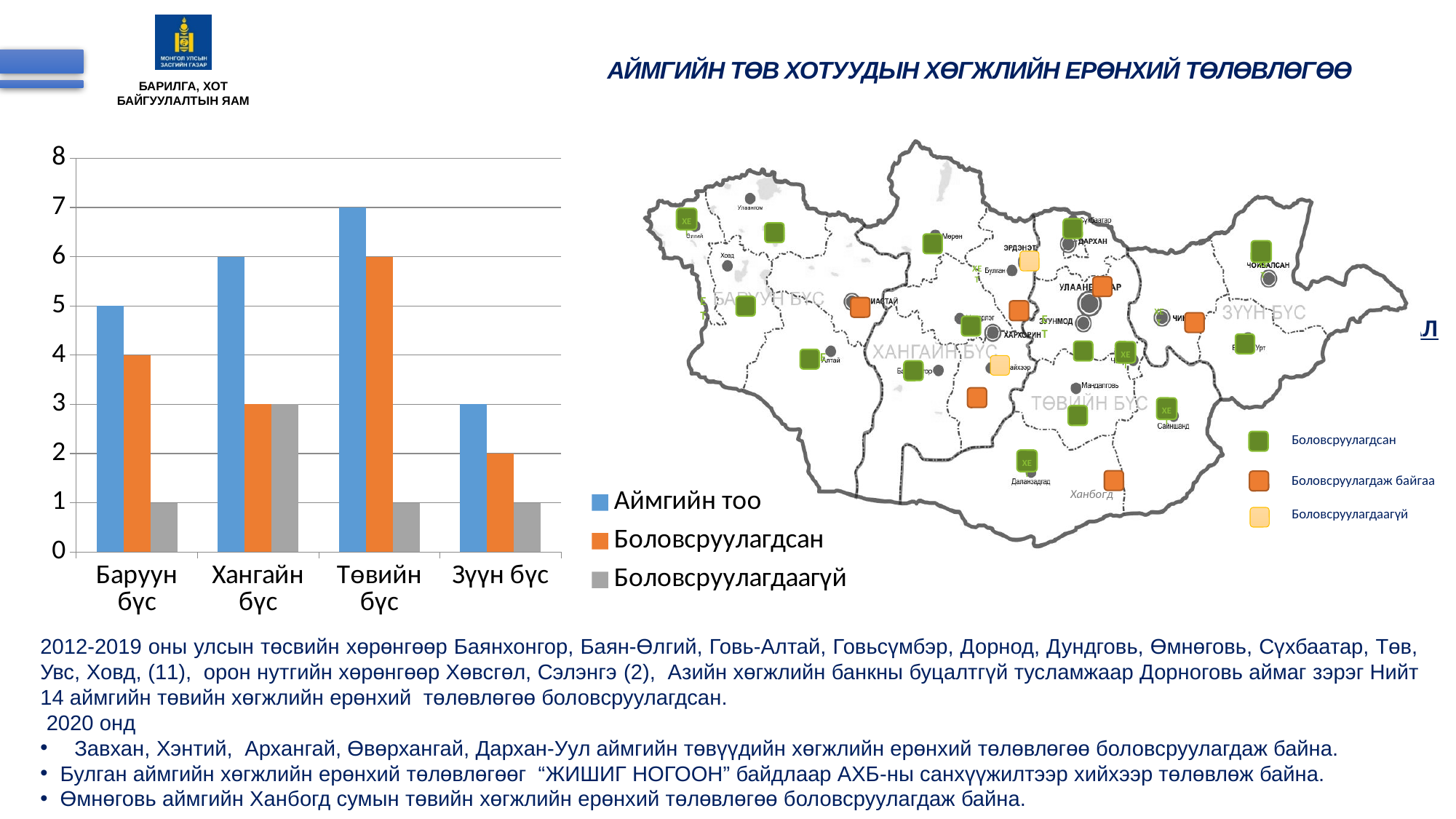
What is the value of Аймгийн тоо for Төвийн бүс? 7 Which region has the lowest value for Аймгийн тоо? Зүүн бүс How many categories (regions) are shown on the x axis of the bar chart? 4 Does the value of Аймгийн тоо rise or fall from Төвийн бүс to Зүүн бүс? fall What kind of chart is shown on the left of the slide? bar chart Which colour represents the Боловсруулагдсан series in the bar chart? orange How many series does the legend of the bar chart list? 3 Which is larger for Төвийн бүс: Боловсруулагдсан or Боловсруулагдаагүй? Боловсруулагдсан Which region has the highest value for Аймгийн тоо? Төвийн бүс What is the value of Боловсруулагдсан for Баруун бүс? 4 What is the difference between Аймгийн тоо and Боловсруулагдсан for Хангайн бүс? 3 What is the value of Боловсруулагдаагүй for Хангайн бүс? 3